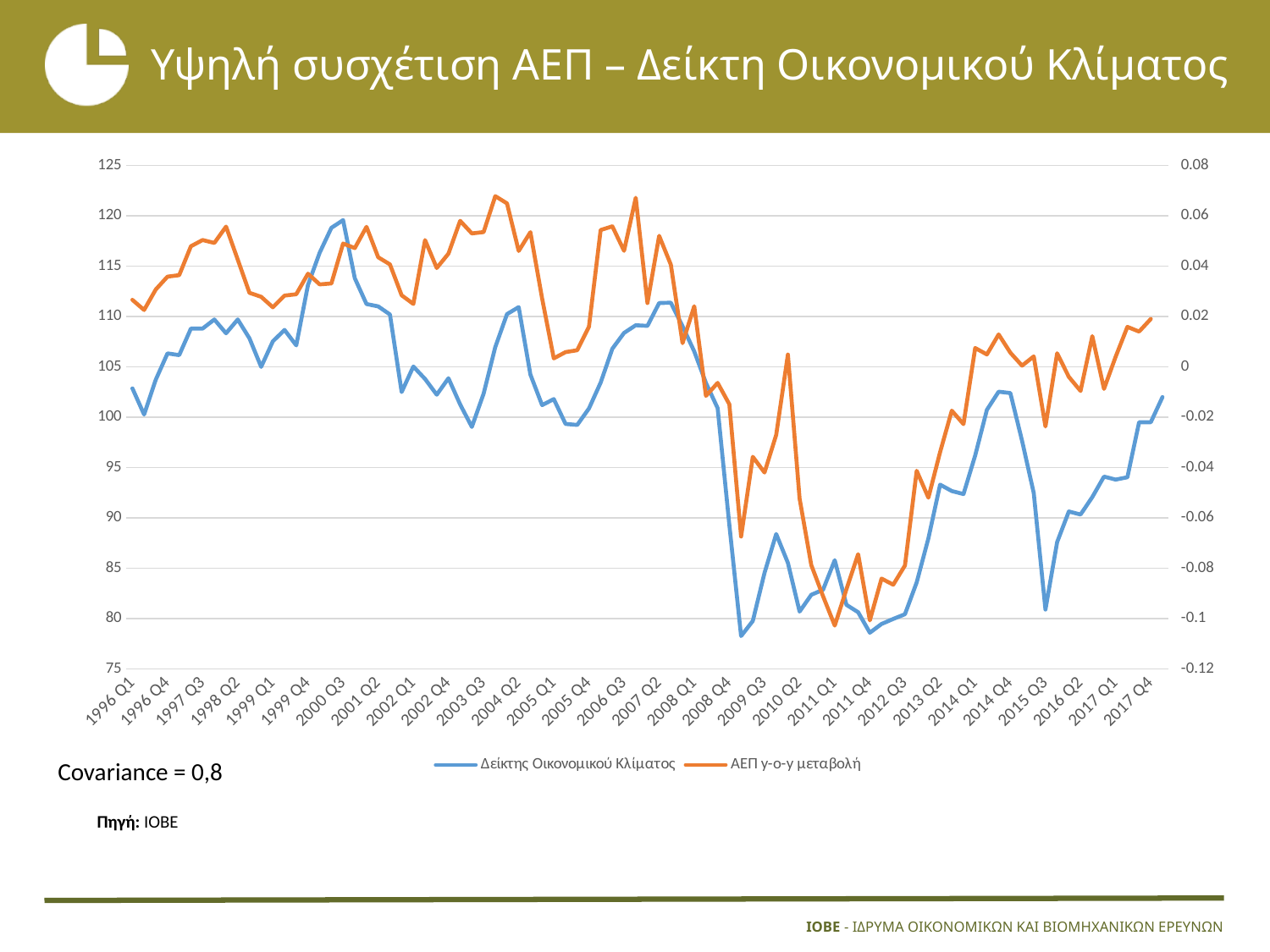
Does the ΑΕΠ y-o-y μεταβολή line rise or fall between 2011 Q4 and 2013 Q2? rise Does the Δείκτης Οικονομικού Κλίματος line rise or fall between 2008 Q1 and 2008 Q4? fall Is the highest value of the ΑΕΠ y-o-y μεταβολή line greater or less than 0.06? greater Is the lowest value of the ΑΕΠ y-o-y μεταβολή line greater or less than -0.08? less Which series is drawn in orange? ΑΕΠ y-o-y μεταβολή What covariance value is stated on the slide? 0,8 Is the highest value of the Δείκτης Οικονομικού Κλίματος line greater or less than 115? greater How many series does the legend list? 2 What kind of chart is shown on the slide? Line chart Does the Δείκτης Οικονομικού Κλίματος line rise or fall between 2015 Q3 and 2017 Q4? rise